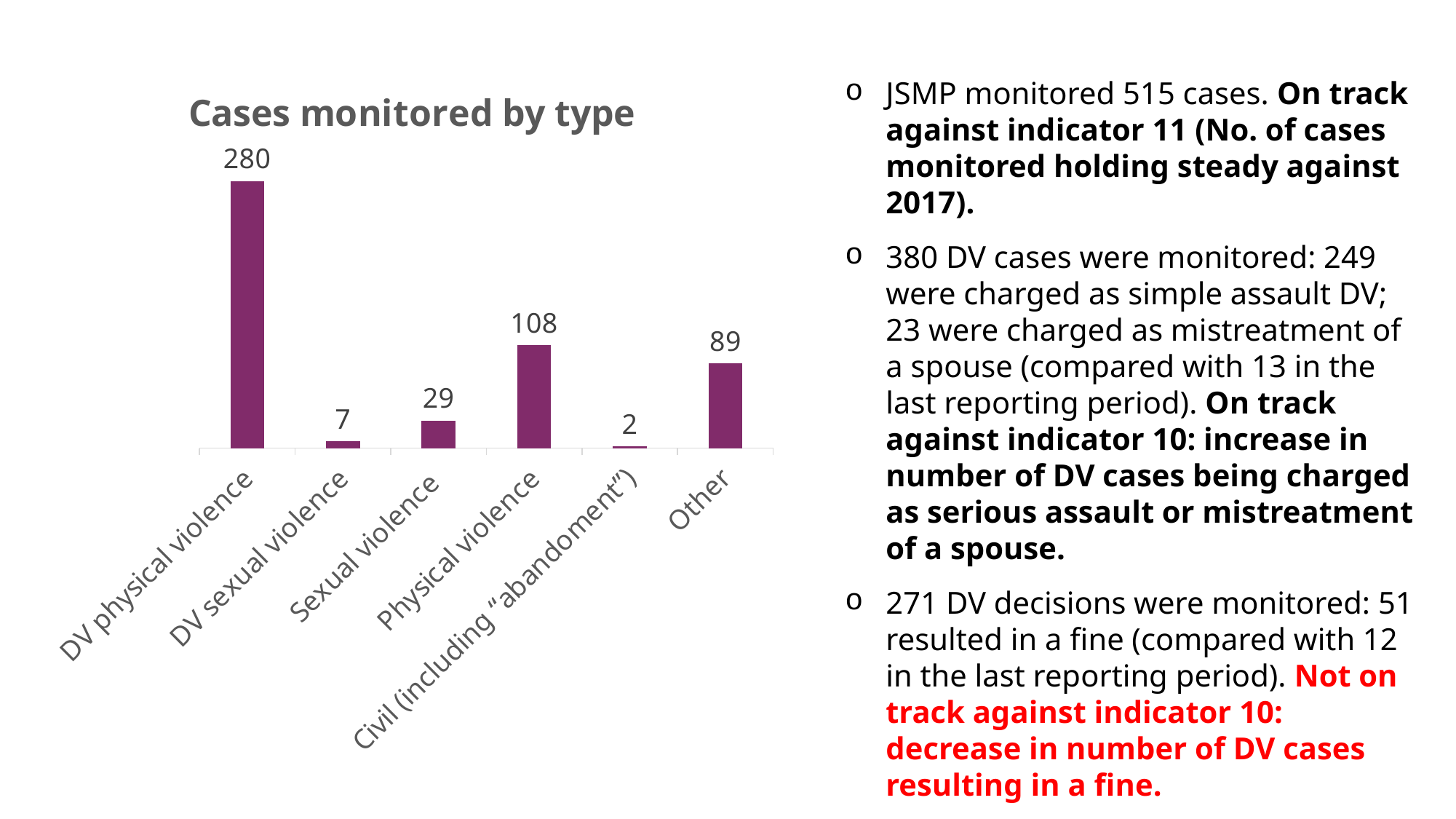
What is the value for DV physical violence? 280 What is the difference between Sexual violence and DV sexual violence? 22 What is the title of the chart? Cases monitored by type What is the value for Other? 89 Which category has the lowest value? Civil (including "abandoment") Which is larger, Physical violence or Other? Physical violence What kind of chart is shown? Bar chart What is the difference between DV physical violence and Physical violence? 172 How many categories are shown in the chart? 6 What is the value for Physical violence? 108 Which category has the highest value? DV physical violence What is the value for Sexual violence? 29